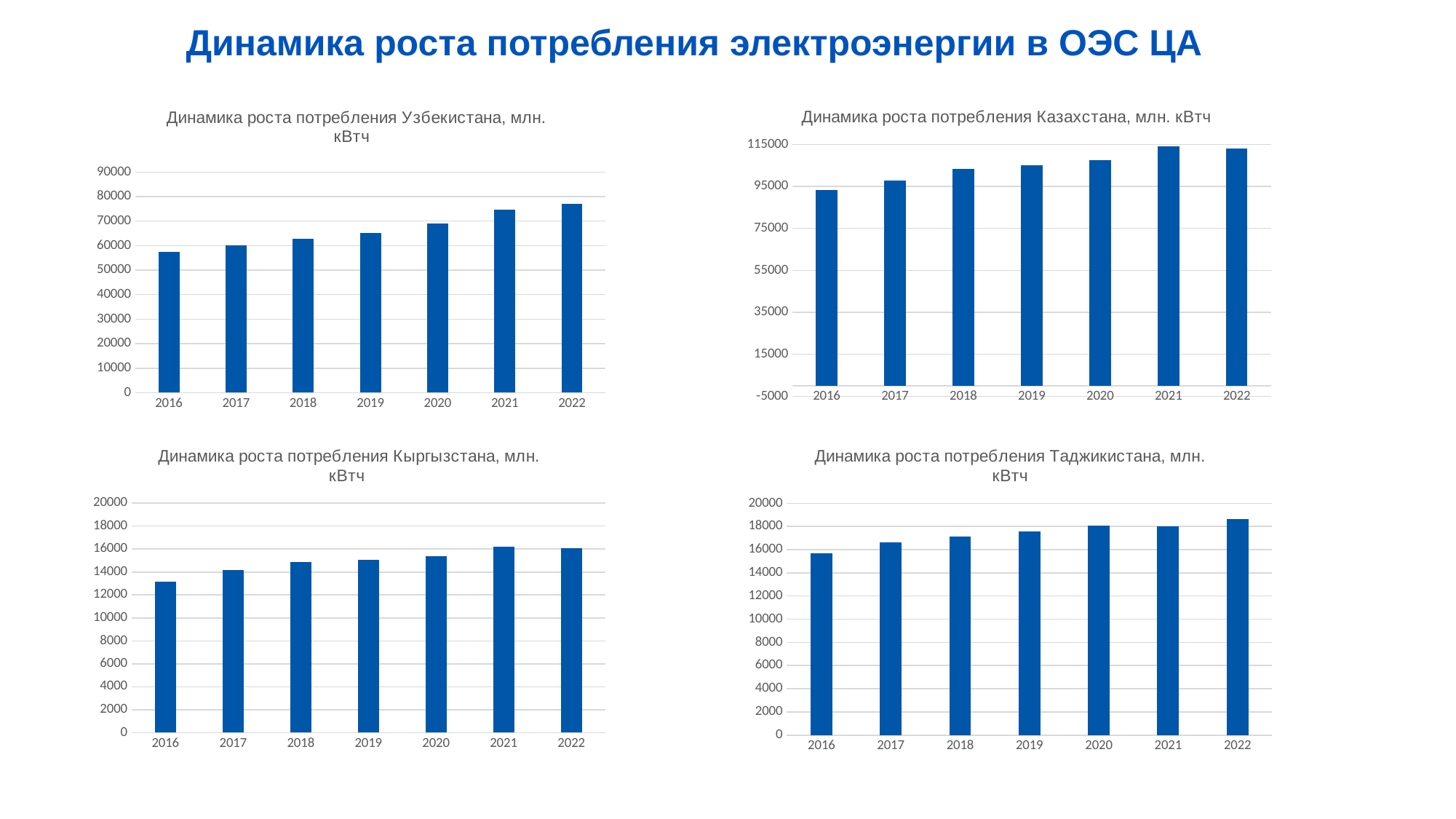
In the 'Динамика роста потребления Казахстана, млн. кВтч' chart, which year has the lowest value? 2016 In the 'Динамика роста потребления Кыргызстана, млн. кВтч' chart, is the value for 2016 greater or less than 14000? less How many charts are shown on the slide? 4 In the 'Динамика роста потребления Кыргызстана, млн. кВтч' chart, which is larger, the value for 2016 or the value for 2021? 2021 In the 'Динамика роста потребления Казахстана, млн. кВтч' chart, how many years are plotted? 7 In the 'Динамика роста потребления Узбекистана, млн. кВтч' chart, is the value for 2016 greater or less than 50000? greater In the 'Динамика роста потребления Таджикистана, млн. кВтч' chart, which year has the highest value? 2022 What kind of chart is the 'Динамика роста потребления Узбекистана, млн. кВтч' chart? bar chart In the 'Динамика роста потребления Таджикистана, млн. кВтч' chart, is the value for 2022 greater or less than 18000? greater In the 'Динамика роста потребления Узбекистана, млн. кВтч' chart, which year has the highest value? 2022